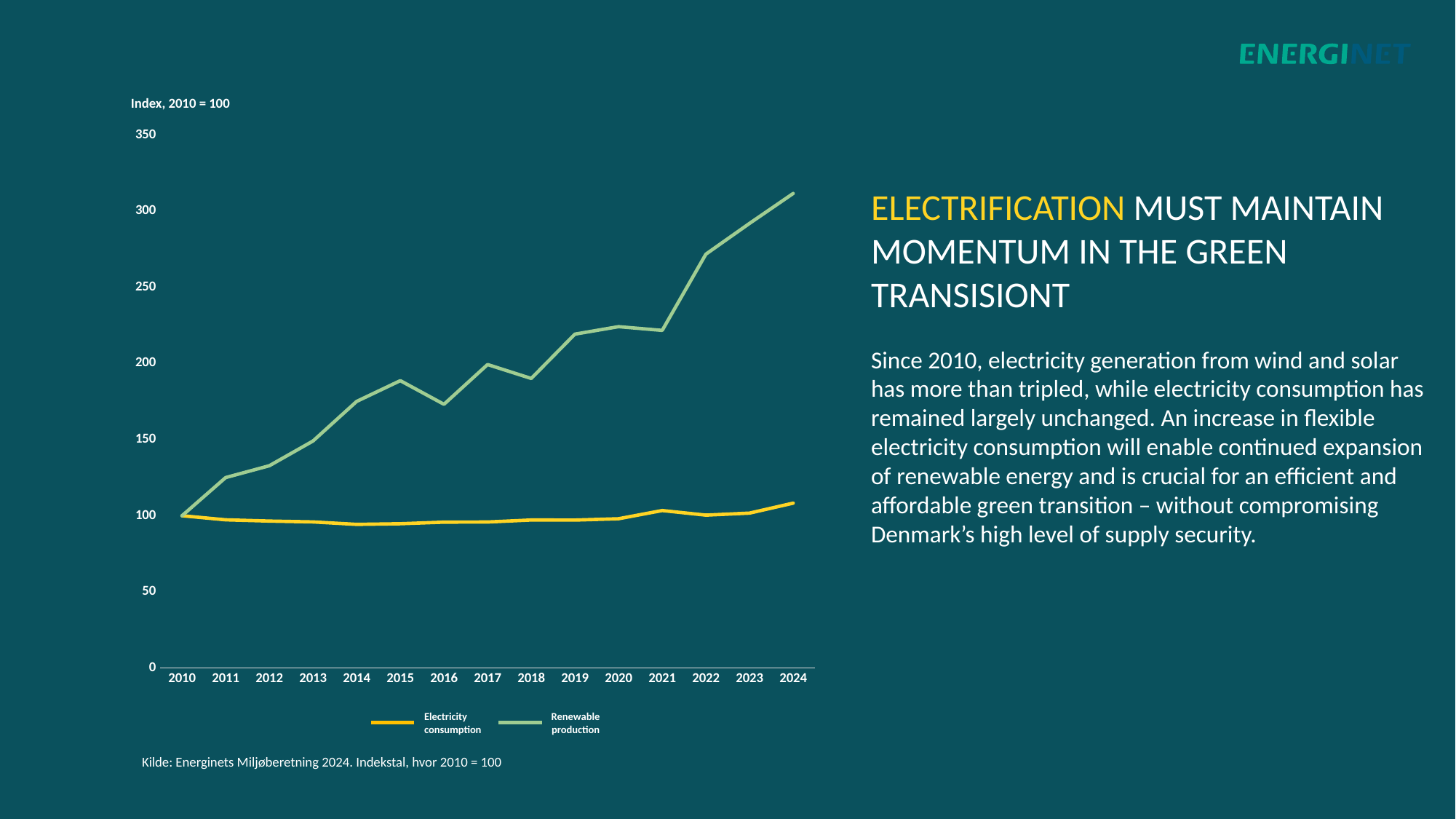
What is the index value for Electricity consumption in 2010? 100 Is the value for Renewable production in 2024 greater or less than 250? greater Is the value for Electricity consumption in 2024 greater or less than 150? less Is the value for Renewable production in 2015 greater or less than 200? less How many series does the chart legend list? 2 How many years are shown on the x axis of the chart? 15 Does Renewable production generally rise or fall from 2010 to 2024? rise In which year is Renewable production lowest? 2010 What is the index value for Renewable production in 2010? 100 In which year is Renewable production highest? 2024 What kind of chart is shown on the slide? line chart In 2024, which series has the larger value, Electricity consumption or Renewable production? Renewable production